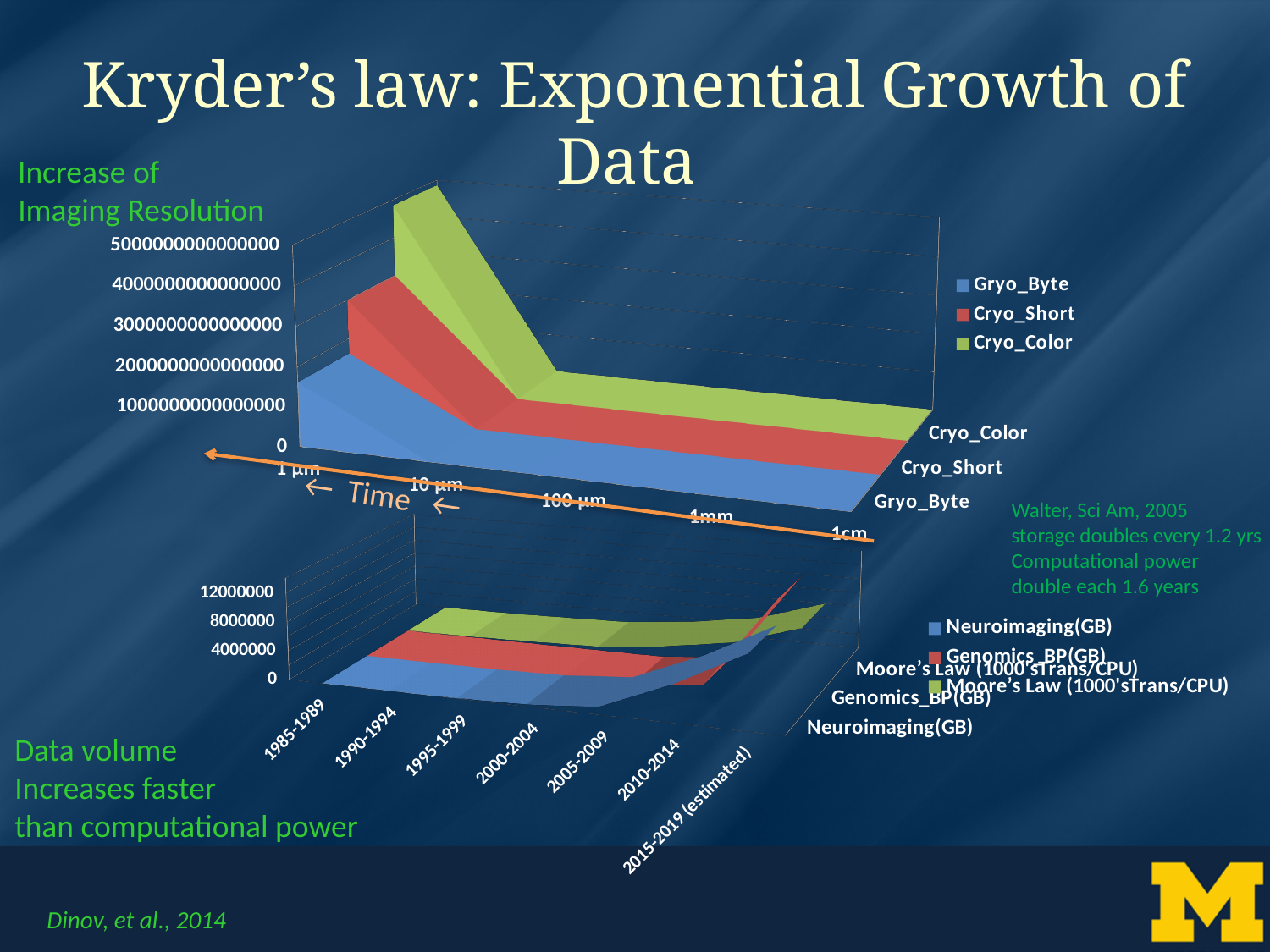
In the bottom chart, do the values for Moore's Law (1000'sTrans/CPU) rise or fall from 1985-1989 to 2015-2019 (estimated)? rise What kind of chart is the top chart on the slide? area chart What is the highest tick value shown on the vertical axis of the bottom chart? 12000000 In the top chart, do the values for Cryo_Color rise or fall when moving from 1 µm to 1cm? fall In the top chart, which x-axis category has the highest value for Cryo_Color? 1 µm In the bottom chart, which time period has the highest value for Moore's Law (1000'sTrans/CPU)? 2015-2019 (estimated) How many series does the legend of the bottom chart list? 3 How many categories are shown on the x axis of the top chart? 5 How many time periods are shown on the x axis of the bottom chart? 7 What kind of chart is the bottom chart on the slide? line chart How many series does the legend of the top chart list? 3 What is the last category label on the x axis of the bottom chart? 2015-2019 (estimated)